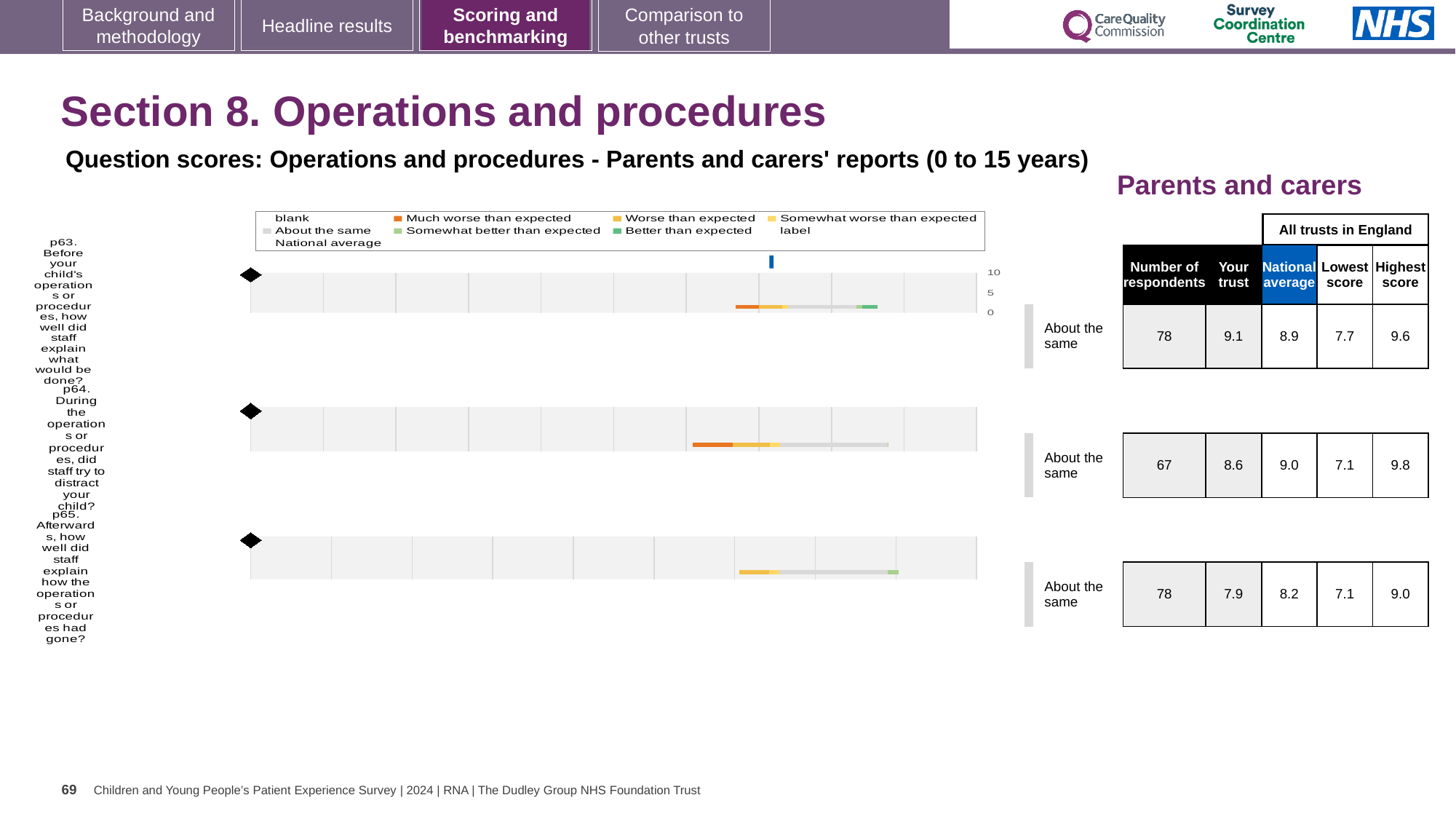
What is the national average score for p64 (did staff try to distract your child during the operation)? 9.0 How many respondents answered p64? 67 What is the highest score across all trusts in England for p65 (how well staff explained how the operation had gone)? 9.0 For p64, which is larger: the 'Your trust' score or the national average? National average For p63, what is the difference between the 'Your trust' score and the national average? 0.2 Which question has the lowest 'Your trust' score? p65 Which question has the highest 'Your trust' score? p63 What is the lowest score across all trusts in England for p63? 7.7 What is the 'Your trust' score for p63 (how well staff explained what would be done before the operation)? 9.1 How many questions (p63, p64, p65) are plotted on this slide? 3 What kind of chart is used to show the benchmarking results for each question on this slide? bar chart What benchmark category is shown for p65? About the same